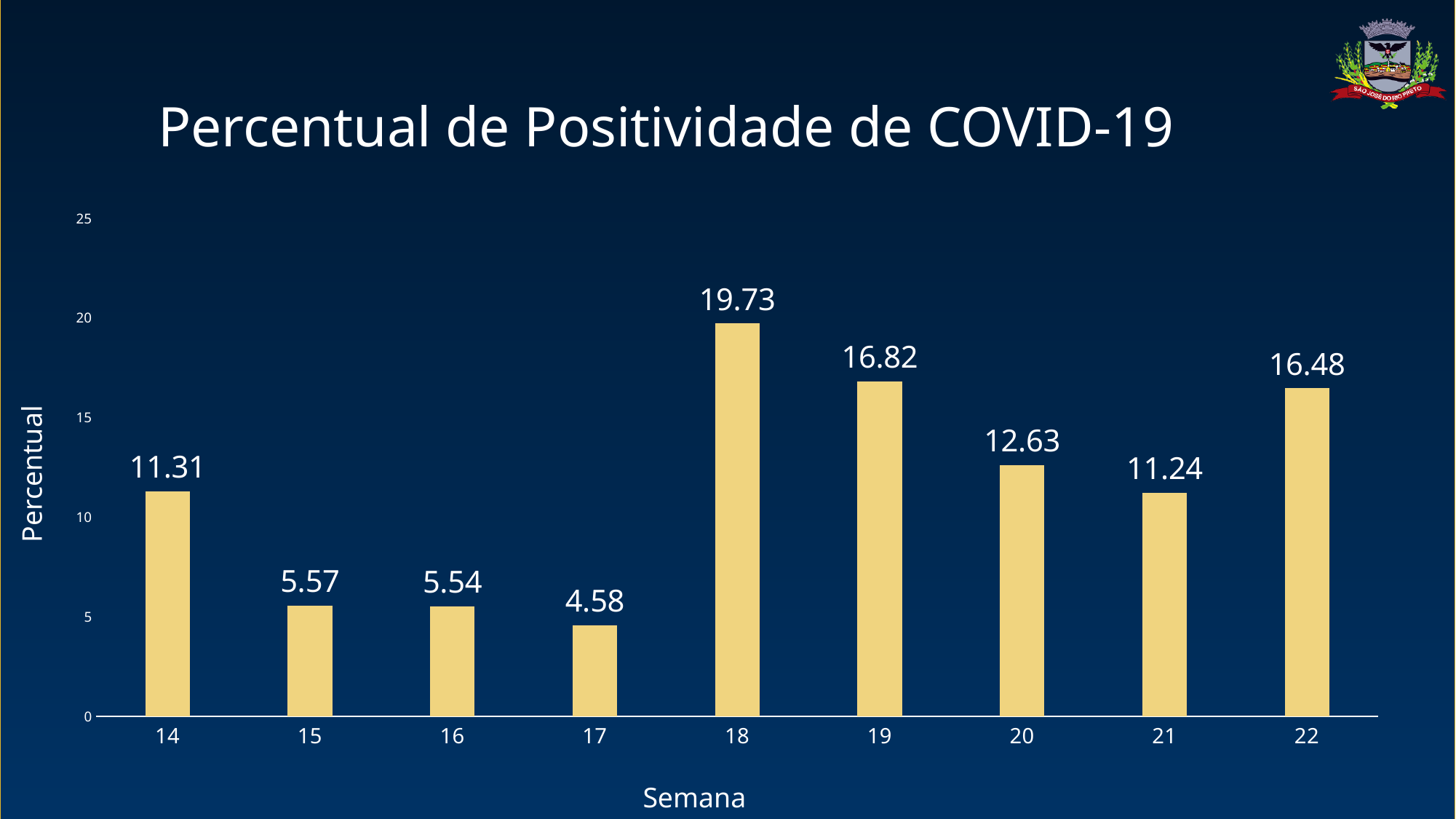
How many semanas are shown on the x axis? 9 What is the title of the chart? Percentual de Positividade de COVID-19 What is the percentual value for semana 18? 19.73 What is the percentual value for semana 22? 16.48 What is the difference between the values for semana 14 and semana 21? 0.07 Which semana has the highest percentual value? 18 What is the percentual value for semana 15? 5.57 What kind of chart is shown on the slide? bar chart Which is larger, the value for semana 20 or the value for semana 22? semana 22 Is the value for semana 19 greater or less than 15? greater What is the difference between the values for semana 18 and semana 19? 2.91 Which semana has the lowest percentual value? 17